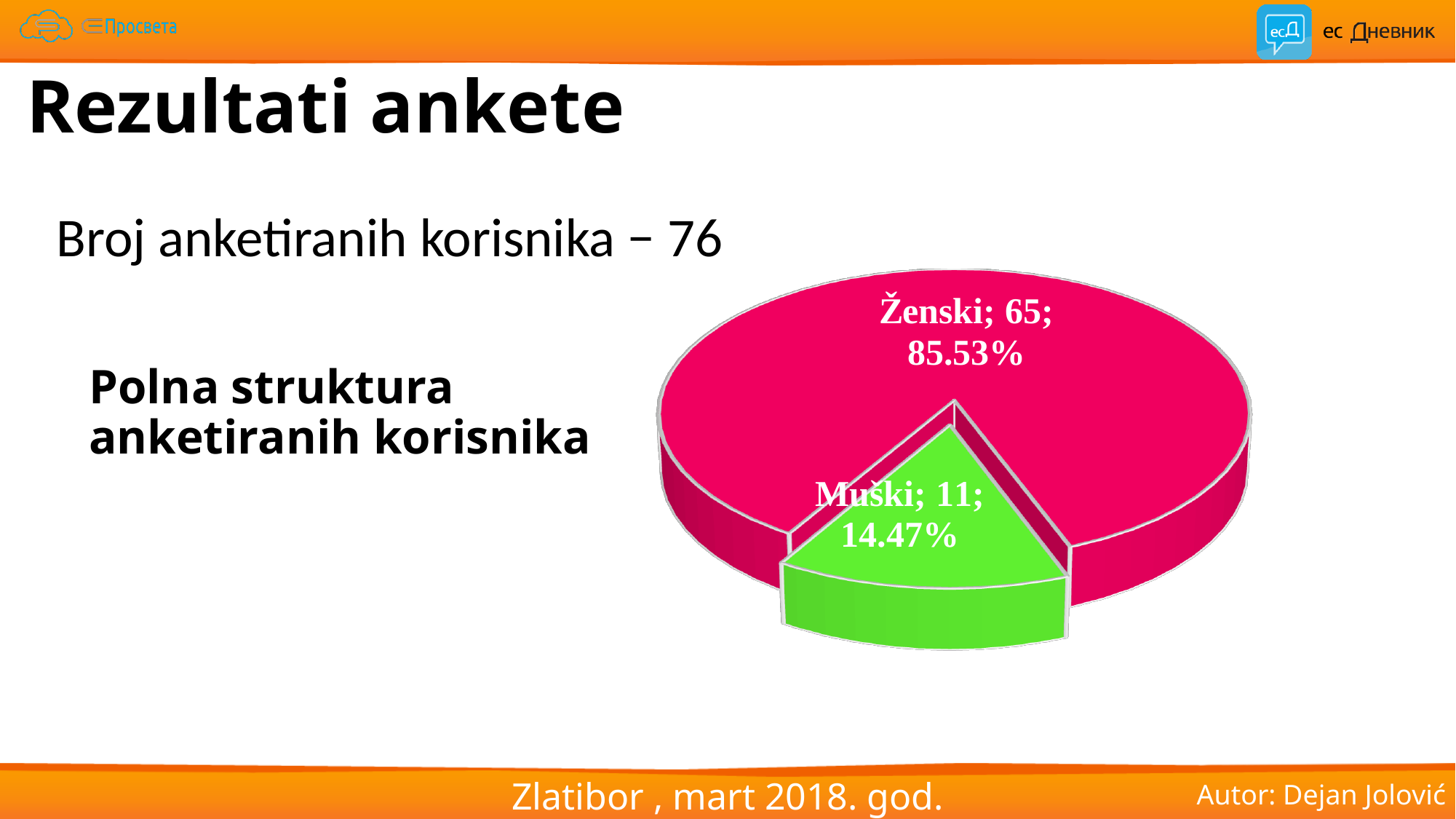
What kind of chart is shown on the slide? pie chart Which is larger, the value for Ženski or the value for Muški? Ženski What is the value for Ženski in the pie chart? 65 What colour is the Muški slice in the pie chart? green How many slices does the pie chart have? 2 Which slice of the pie chart is the smallest? Muški What is the total of the two slices in the pie chart? 76 What is the value for Muški in the pie chart? 11 What is the difference between the Ženski and Muški values? 54 Which slice of the pie chart is the largest? Ženski What share of the pie does the Muški slice represent? 14.47% What share of the pie does the Ženski slice represent? 85.53%